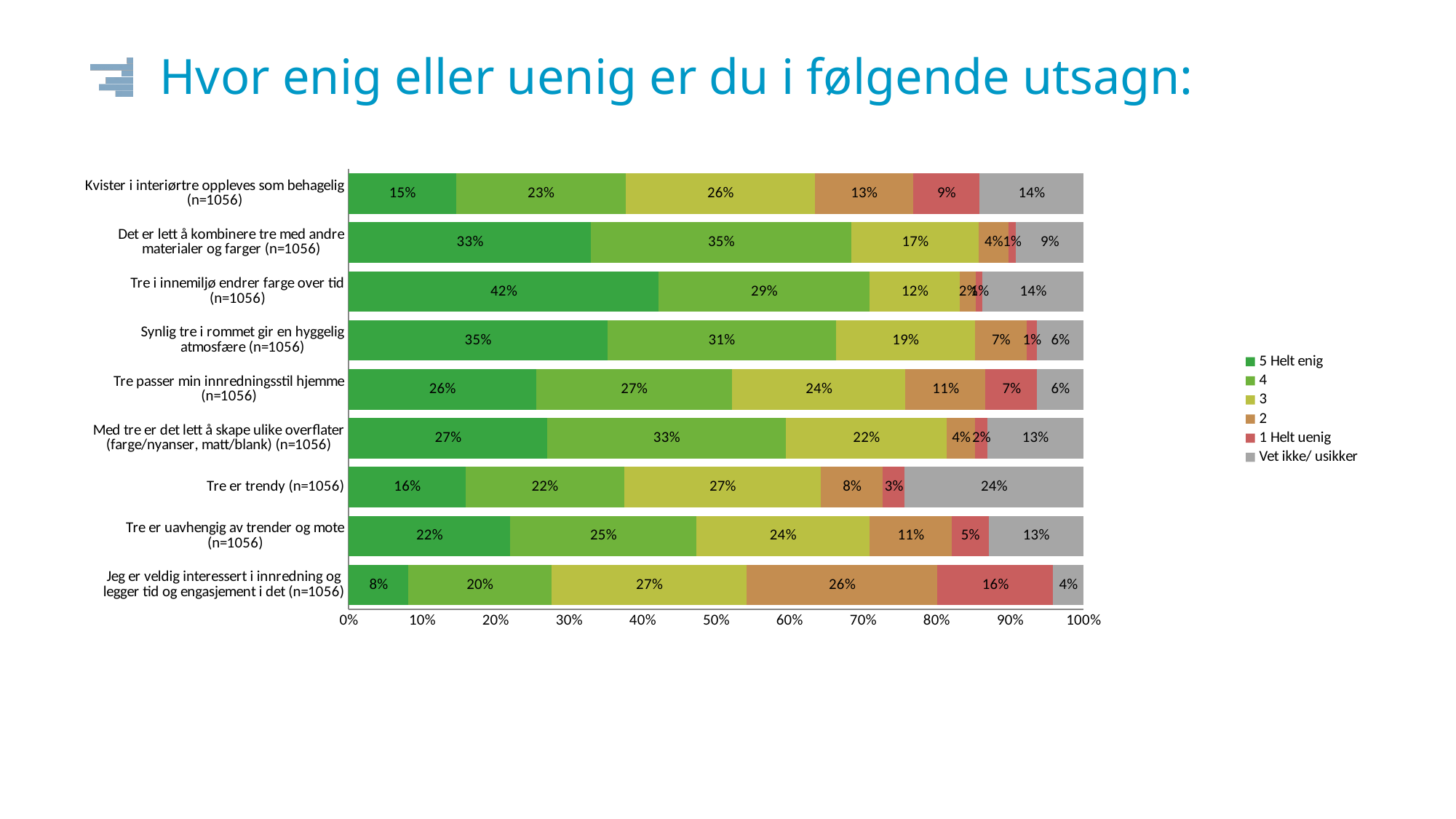
How many series does the legend list? 6 What percentage answered "1 Helt uenig" for "Jeg er veldig interessert i innredning og legger tid og engasjement i det (n=1056)"? 16% What is the difference between the "4" share for "Det er lett å kombinere tre med andre materialer og farger (n=1056)" and the "4" share for "Tre er trendy (n=1056)"? 13% What percentage answered "5 Helt enig" for "Tre i innemiljø endrer farge over tid (n=1056)"? 42% What kind of chart is shown on the slide? Stacked bar chart Which statement has the lowest share of "5 Helt enig" responses? Jeg er veldig interessert i innredning og legger tid og engasjement i det (n=1056) What is the total of the stacked bar for "Tre er uavhengig av trender og mote (n=1056)"? 100% What percentage answered "Vet ikke/ usikker" for "Tre er trendy (n=1056)"? 24% Which has a larger "2" share: "Kvister i interiørtre oppleves som behagelig (n=1056)" or "Synlig tre i rommet gir en hyggelig atmosfære (n=1056)"? Kvister i interiørtre oppleves som behagelig (n=1056) How many statements (categories) are shown in the chart? 9 Which statement has the highest share of "5 Helt enig" responses? Tre i innemiljø endrer farge over tid (n=1056) Which legend entry is shown in grey? Vet ikke/ usikker